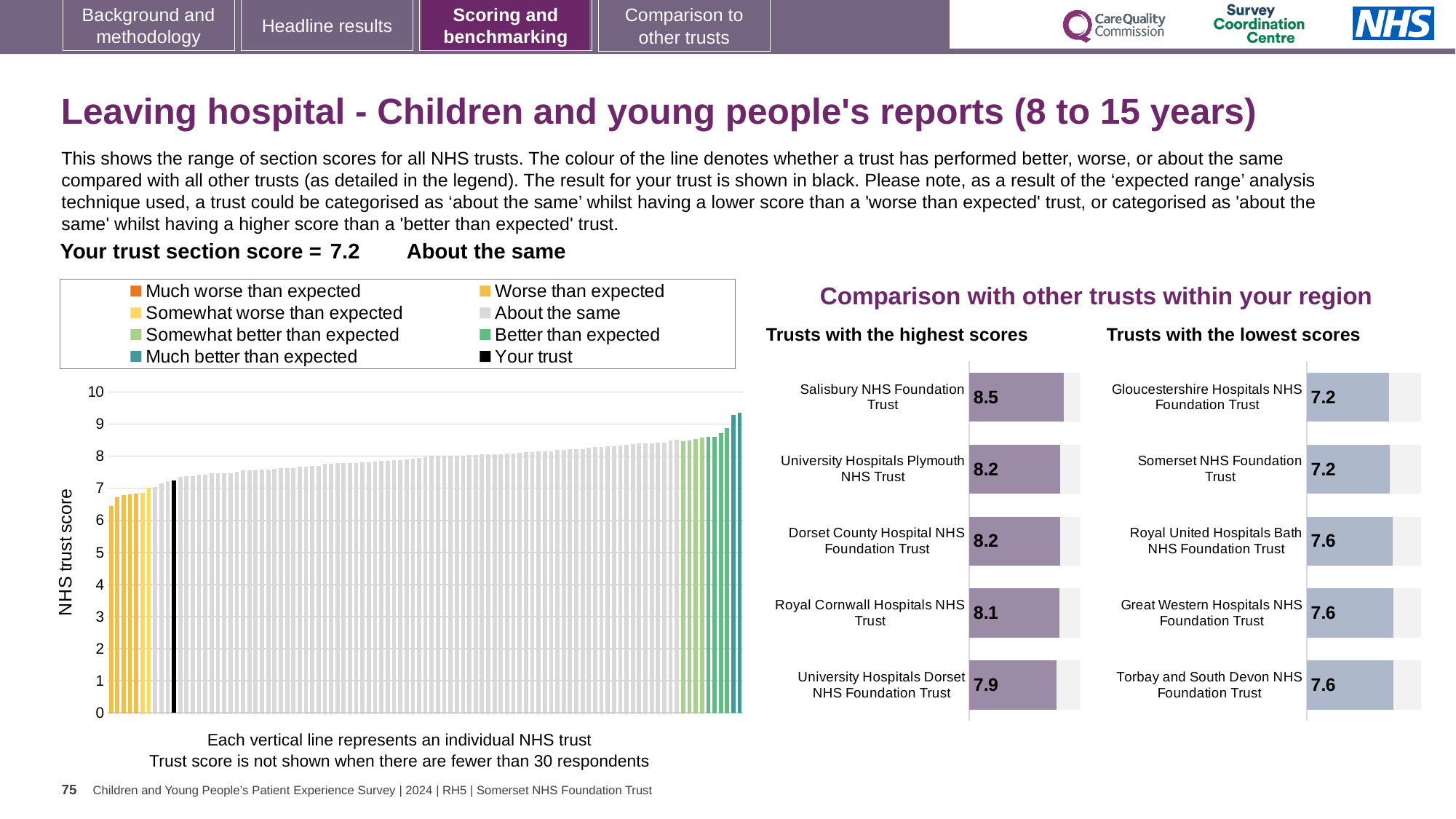
How many entries does the legend of the large chart on the left list? 8 In the 'Trusts with the highest scores' chart, what is the score for Salisbury NHS Foundation Trust? 8.5 In the 'Trusts with the highest scores' chart, what is the difference between the scores of Salisbury NHS Foundation Trust and University Hospitals Dorset NHS Foundation Trust? 0.6 What kind of chart is the large chart on the left with the 'NHS trust score' axis? Bar chart In the 'Trusts with the lowest scores' chart, what is the score for Torbay and South Devon NHS Foundation Trust? 7.6 In the 'Trusts with the lowest scores' chart, what is the difference between the scores of Great Western Hospitals NHS Foundation Trust and Somerset NHS Foundation Trust? 0.4 In the 'Trusts with the lowest scores' chart, which is larger: the score for Somerset NHS Foundation Trust or Royal United Hospitals Bath NHS Foundation Trust? Royal United Hospitals Bath NHS Foundation Trust In the 'Trusts with the highest scores' chart, which trust has the lowest score? University Hospitals Dorset NHS Foundation Trust In the 'Trusts with the lowest scores' chart, what is the score for Gloucestershire Hospitals NHS Foundation Trust? 7.2 In the 'Trusts with the highest scores' chart, what is the score for Royal Cornwall Hospitals NHS Trust? 8.1 In the large chart on the left, do the trust scores rise or fall from left to right? Rise In the 'Trusts with the highest scores' chart, how many trusts are shown? 5